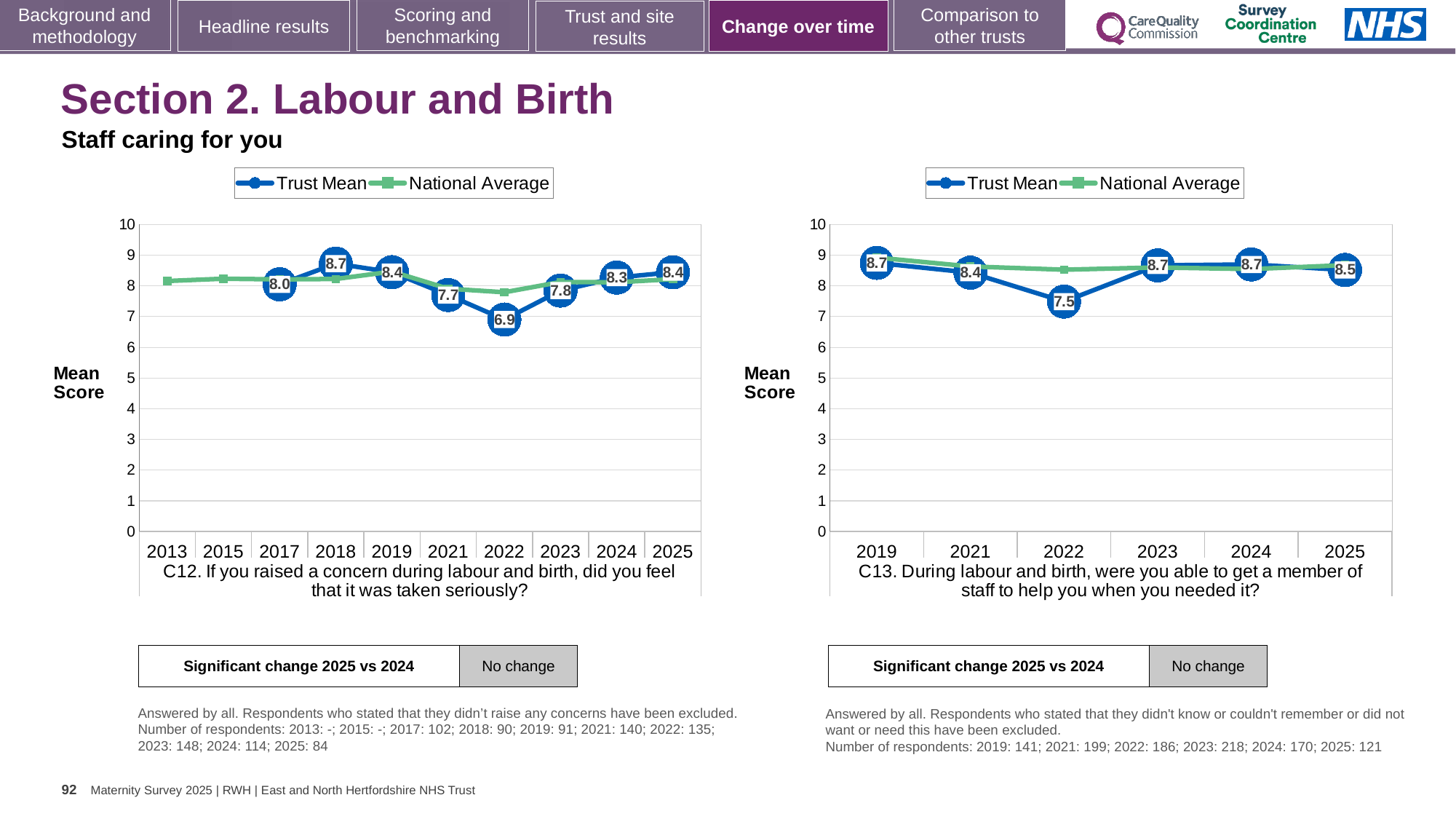
In the C13 chart (right), which year has the lowest Trust Mean? 2022 In the C13 chart (right), what is the Trust Mean for 2022? 7.5 What type of chart is the C12 chart (left)? Line chart How many series does the legend of the C12 chart (left) list? 2 In the C12 chart (left), what is the Trust Mean for 2018? 8.7 In the C13 chart (right), is the Trust Mean higher in 2021 or in 2025? 2025 How many years are shown on the x axis of the C13 chart (right)? 6 In the C12 chart (left), what is the difference between the Trust Mean in 2025 and in 2022? 1.5 In the C13 chart (right), is the National Average for 2022 greater or less than 8? greater In the C12 chart (left), which year has the lowest Trust Mean? 2022 In the C12 chart (left), what is the Trust Mean for 2022? 6.9 In the C12 chart (left), which year has the highest Trust Mean? 2018